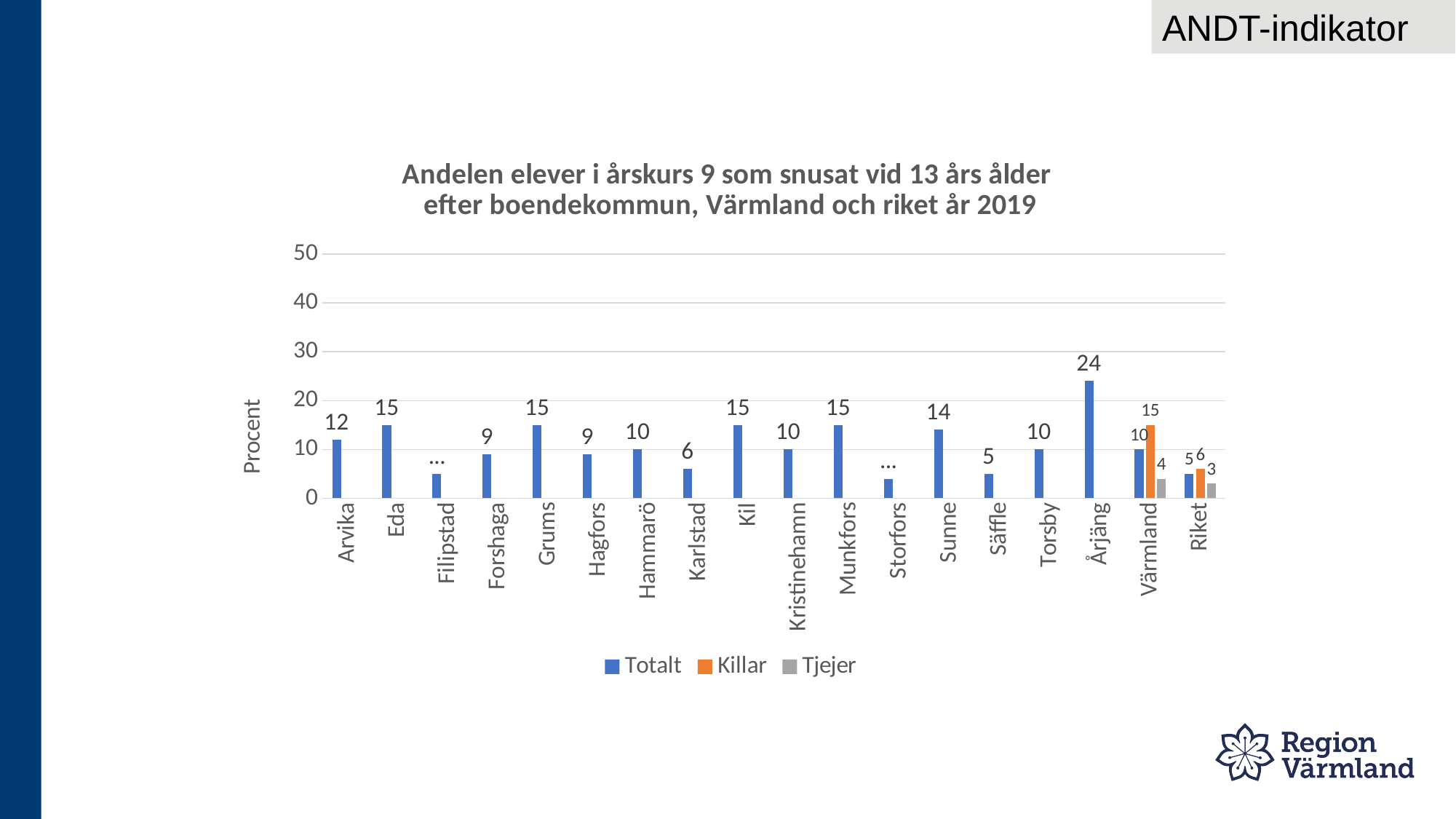
What is the Tjejer value for Riket? 3 How many series does the legend list? 3 What is the Killar value for Värmland? 15 Is the Totalt value for Filipstad greater or less than 10? less What is the difference between the Totalt values for Årjäng and Arvika? 12 What is the difference between the Killar and Tjejer values for Värmland? 11 How many categories are shown on the x axis? 18 Which category has the highest Totalt value? Årjäng Which has a larger Totalt value, Eda or Forshaga? Eda What kind of chart is shown on the slide? Bar chart What is the Totalt value for Årjäng? 24 What is the Totalt value for Karlstad? 6